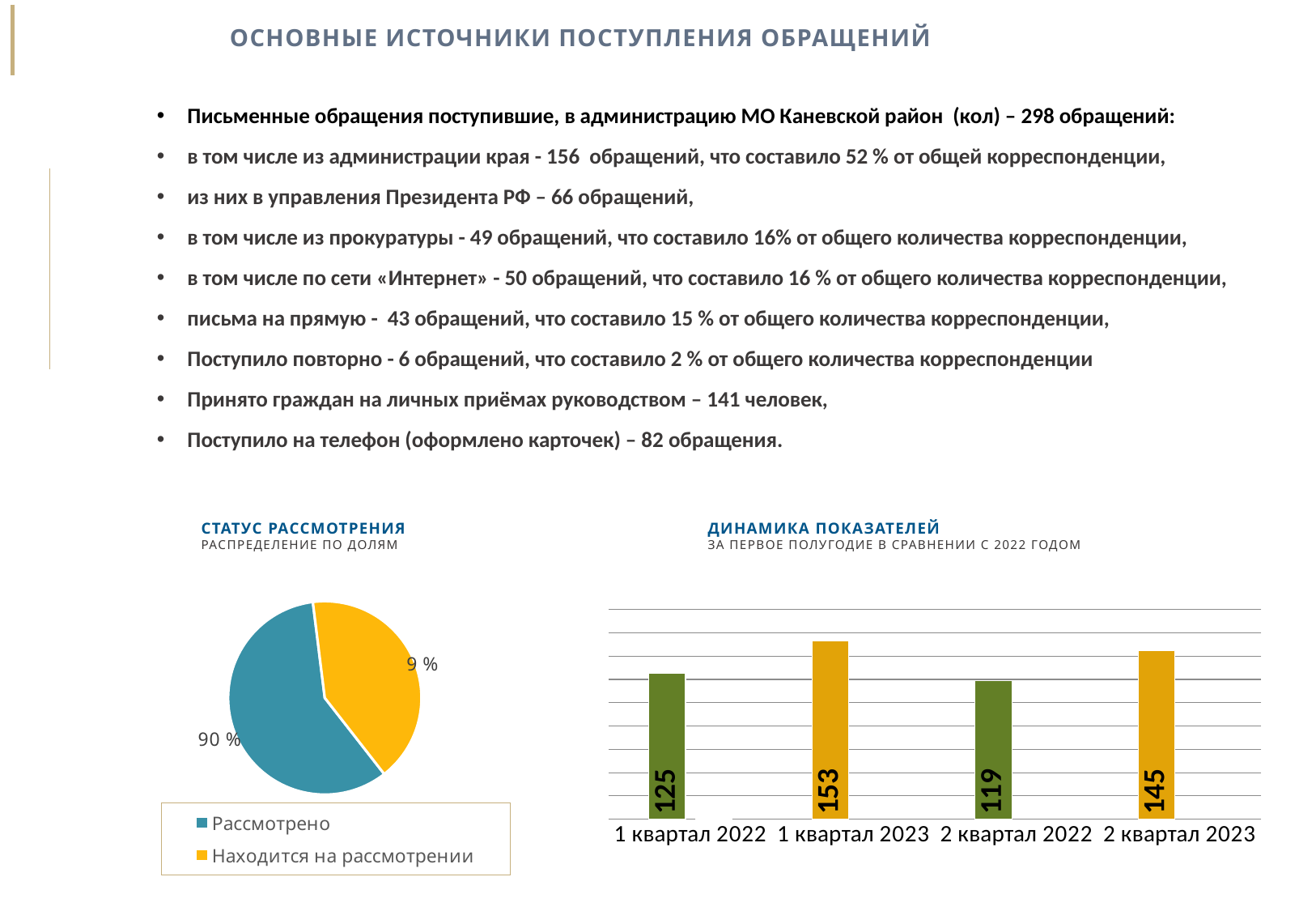
How many bars are shown on the 'ДИНАМИКА ПОКАЗАТЕЛЕЙ' chart? 4 On the 'ДИНАМИКА ПОКАЗАТЕЛЕЙ' chart, which category has the lowest value? 2 квартал 2022 On the 'СТАТУС РАССМОТРЕНИЯ' pie chart, what percentage is labelled for 'Рассмотрено'? 90 % What type of chart is 'ДИНАМИКА ПОКАЗАТЕЛЕЙ'? Bar chart How many entries does the legend of the 'СТАТУС РАССМОТРЕНИЯ' pie chart list? 2 On the 'ДИНАМИКА ПОКАЗАТЕЛЕЙ' chart, what is the difference between 1 квартал 2023 and 1 квартал 2022? 28 On the 'ДИНАМИКА ПОКАЗАТЕЛЕЙ' chart, which category has the highest value? 1 квартал 2023 On the 'ДИНАМИКА ПОКАЗАТЕЛЕЙ' chart, what is the value for 2 квартал 2022? 119 On the 'ДИНАМИКА ПОКАЗАТЕЛЕЙ' chart, what is the value for 1 квартал 2023? 153 On the 'ДИНАМИКА ПОКАЗАТЕЛЕЙ' chart, which is larger: 1 квартал 2023 or 2 квартал 2023? 1 квартал 2023 On the 'ДИНАМИКА ПОКАЗАТЕЛЕЙ' chart, what is the difference between 2 квартал 2023 and 2 квартал 2022? 26 On the 'ДИНАМИКА ПОКАЗАТЕЛЕЙ' chart, what is the value for 1 квартал 2022? 125